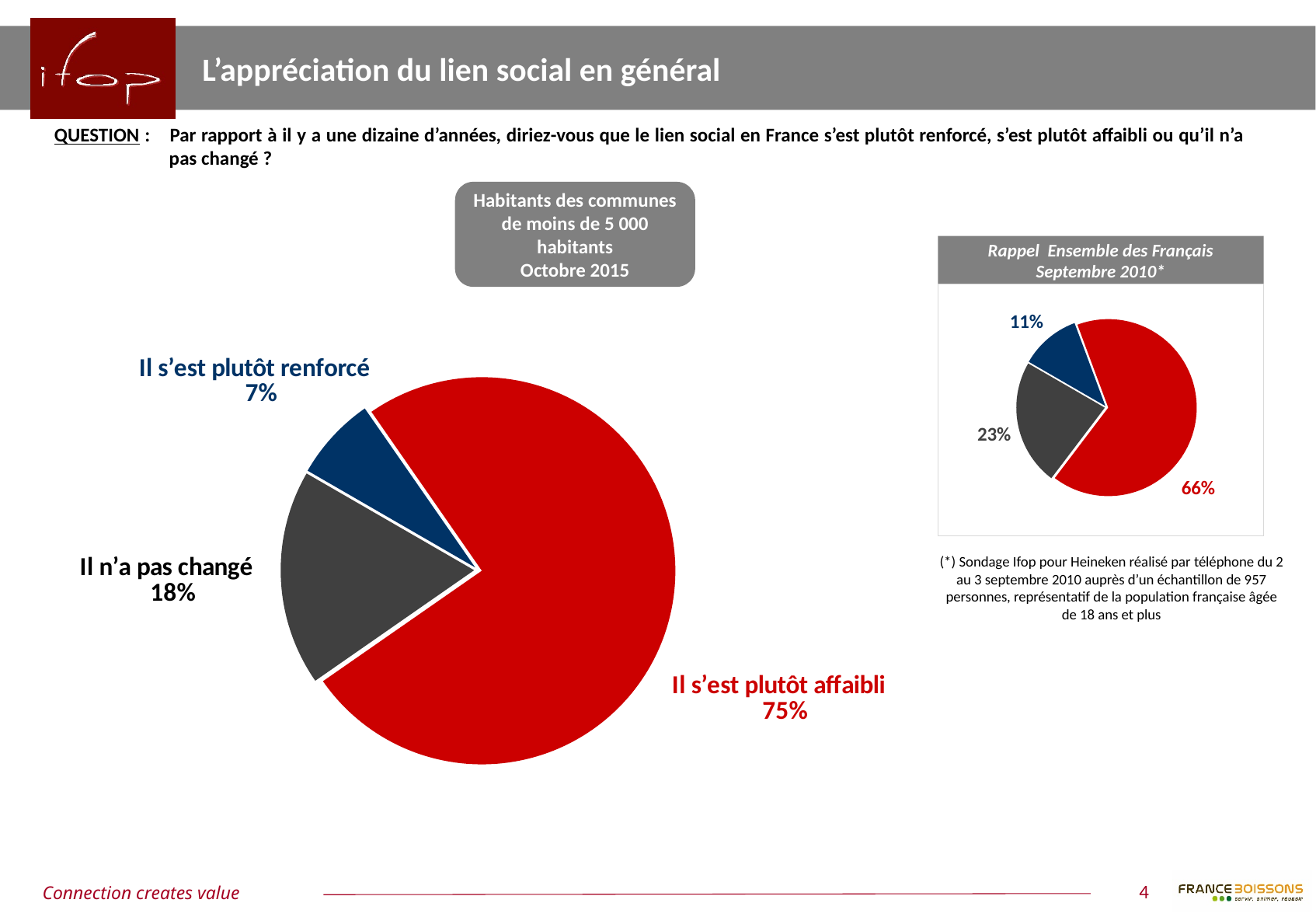
In the large pie chart (Octobre 2015), what is the difference between "Il s'est plutôt affaibli" and "Il n'a pas changé"? 57 percentage points In the small pie chart "Rappel Ensemble des Français Septembre 2010", what is the value of the blue slice? 11% In the large pie chart (Octobre 2015), what is the value for "Il n'a pas changé"? 18% What kind of chart is used on this slide? Pie chart In the large pie chart (Octobre 2015), which category has the smallest share? Il s'est plutôt renforcé Which is larger: the grey slice in the small pie chart (Septembre 2010) or the "Il n'a pas changé" slice in the large pie chart (Octobre 2015)? The grey slice in the small pie chart (23%) How many slices does the large pie chart (Octobre 2015) have? 3 In the small pie chart "Rappel Ensemble des Français Septembre 2010", what is the value of the red slice? 66% What colour is the "Il s'est plutôt affaibli" slice in the large pie chart? Red In the large pie chart (Octobre 2015), what is the value for "Il s'est plutôt renforcé"? 7% In the large pie chart (Octobre 2015), what is the value for "Il s'est plutôt affaibli"? 75% In the large pie chart (Octobre 2015), which category has the largest share? Il s'est plutôt affaibli